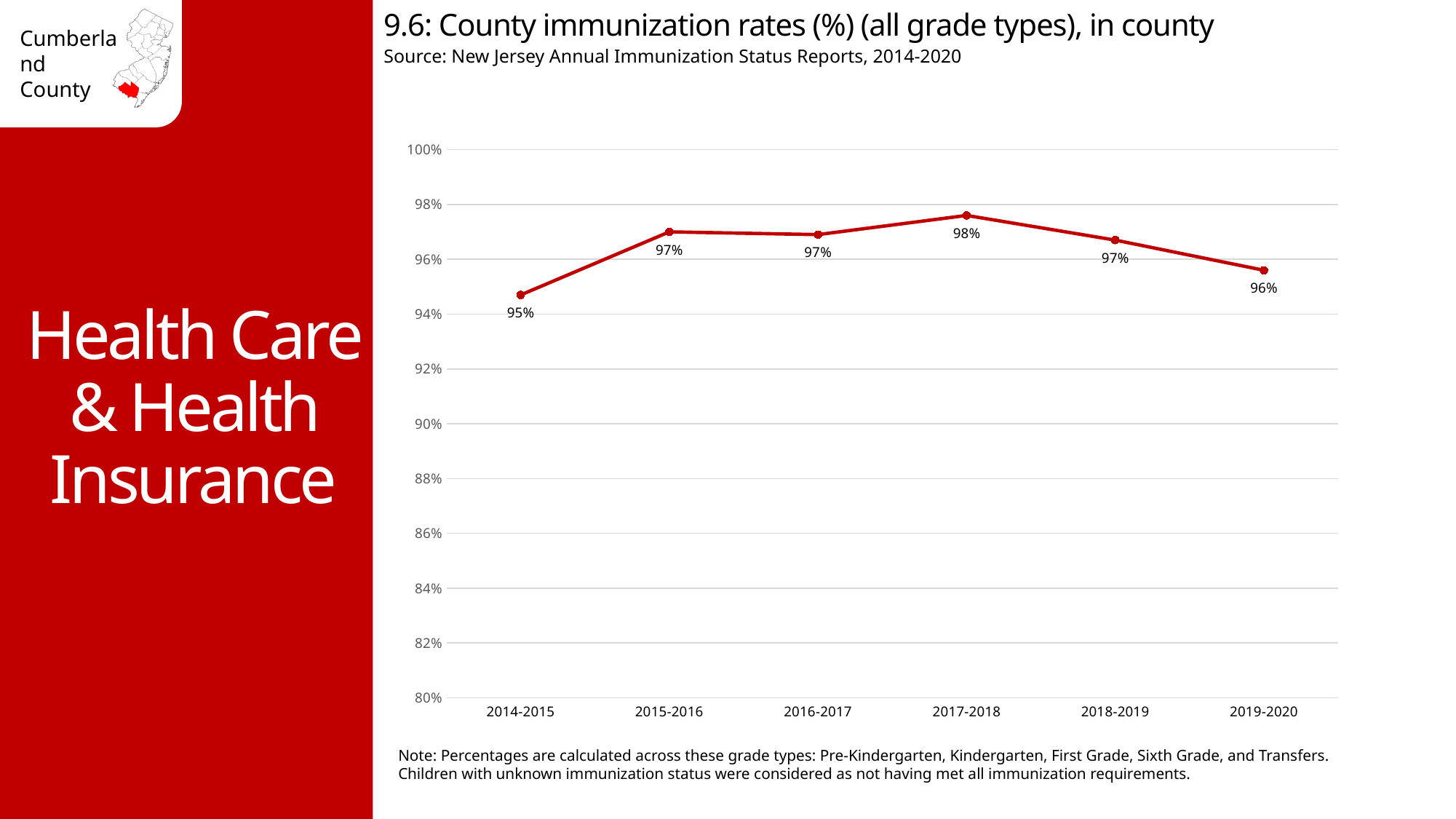
How many school years are plotted on the chart? 6 Is the immunization rate for 2014-2015 greater or less than 96%? less Which school year has the highest immunization rate? 2017-2018 What is the county immunization rate for 2019-2020? 96% What is the county immunization rate for 2017-2018? 98% What is the county immunization rate for 2014-2015? 95% What kind of chart is shown on the slide? line chart Does the immunization rate rise or fall from 2017-2018 to 2019-2020? fall Which is larger, the immunization rate in 2014-2015 or in 2019-2020? 2019-2020 Which school year has the lowest immunization rate? 2014-2015 What is the source cited for the chart? New Jersey Annual Immunization Status Reports, 2014-2020 What is the difference between the immunization rate in 2017-2018 and in 2014-2015? 3 percentage points